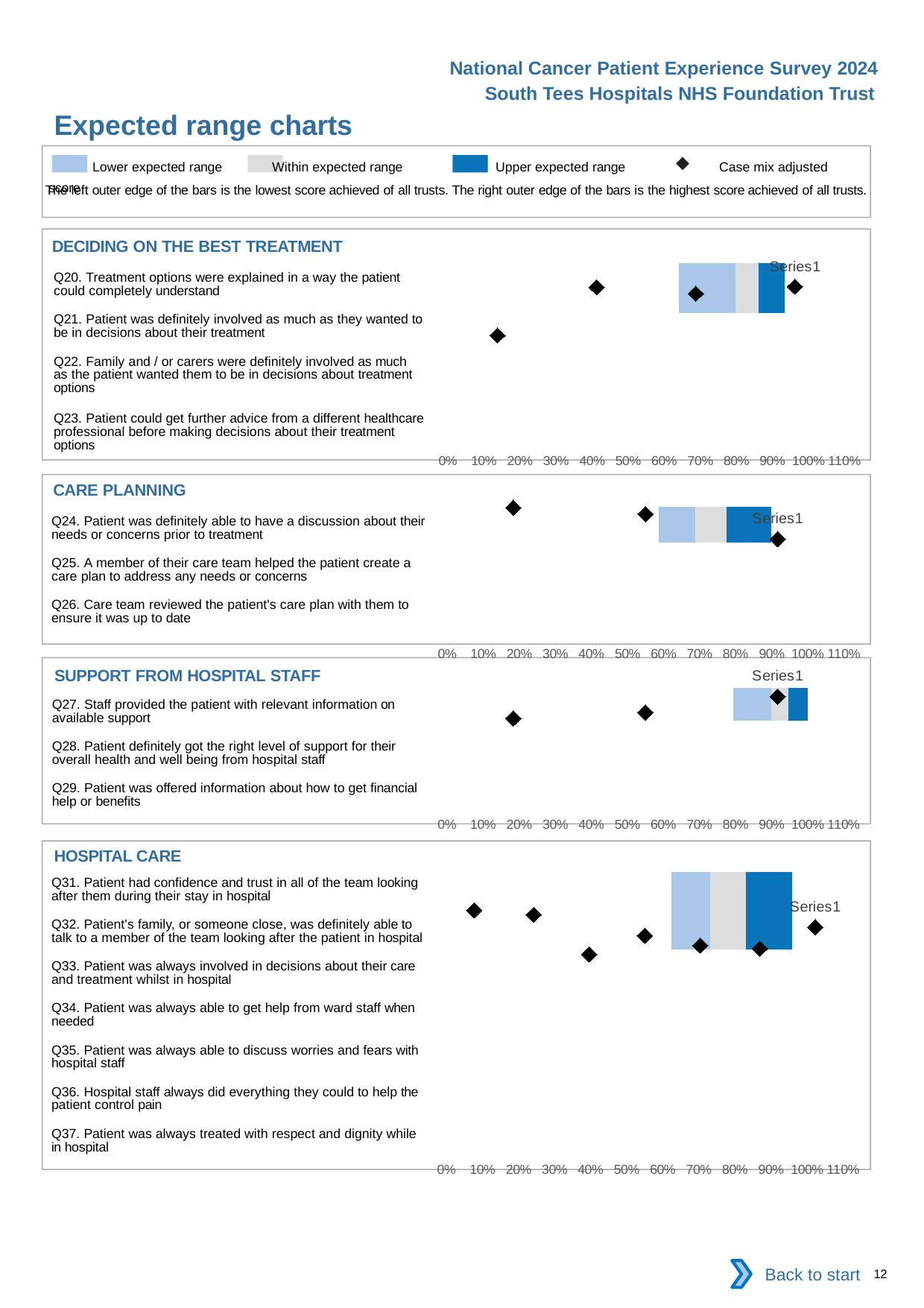
What symbol does the legend use for the case mix adjusted score? A black diamond How many chart sections are shown on the slide? 4 How many entries does the legend at the top of the slide list? 4 In the CARE PLANNING chart, how many questions are listed? 3 In the DECIDING ON THE BEST TREATMENT chart, how many questions are listed? 4 Which chart section lists the most questions? HOSPITAL CARE Which chart sections list the fewest questions? CARE PLANNING and SUPPORT FROM HOSPITAL STAFF What is the highest tick label shown on the x axis of the charts? 110%